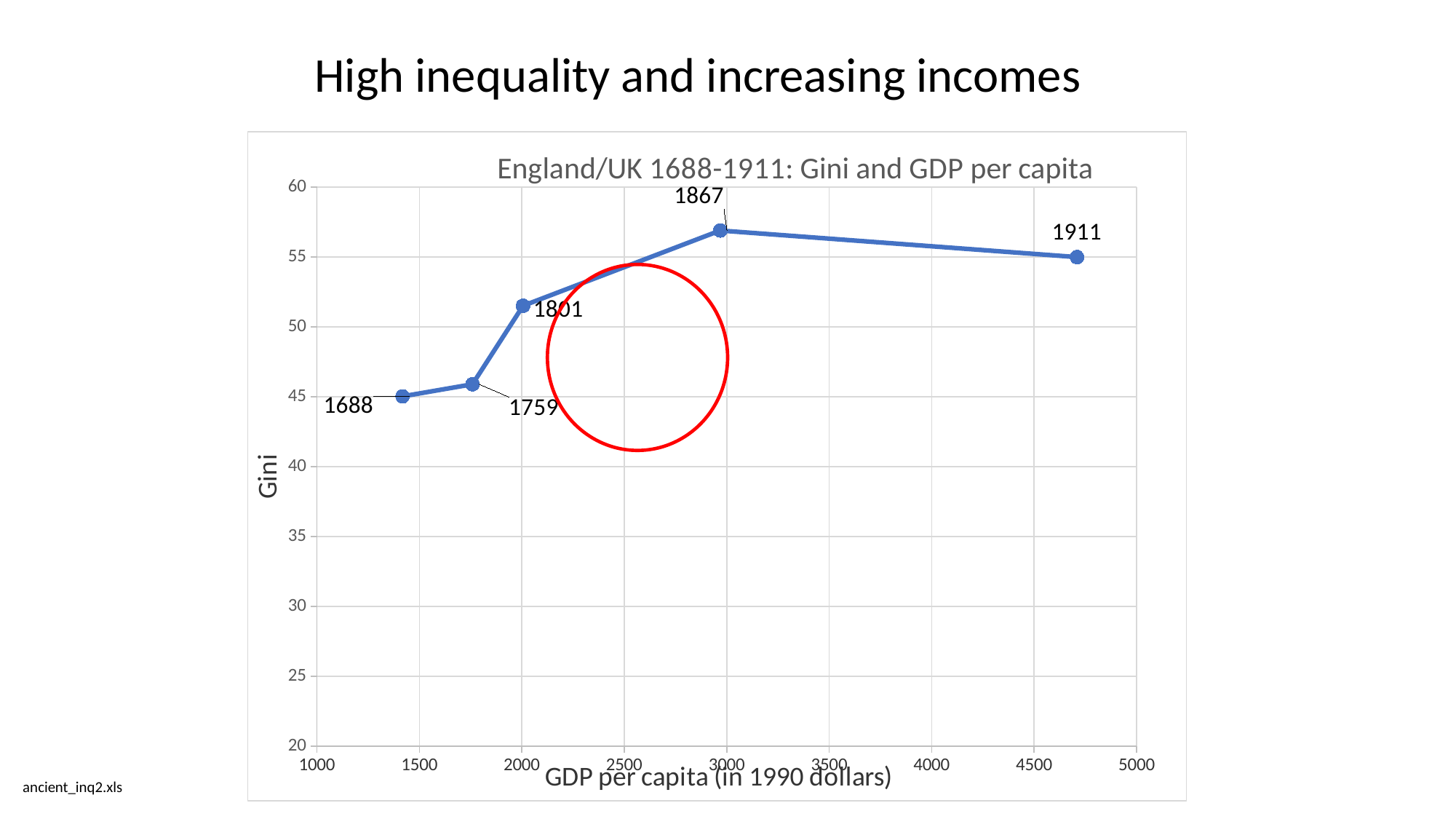
What is the label of the x axis? GDP per capita (in 1990 dollars) Is the Gini value for 1759 greater or less than 50? less What is the Gini value for 1688? 45 How many data points are plotted on the chart? 5 Is the GDP per capita for 1911 greater or less than 4500? greater Is the Gini value for 1801 greater or less than 50? greater Which year has the lowest Gini value? 1688 Which year has the highest Gini value? 1867 Which has the higher Gini value, 1867 or 1911? 1867 What kind of chart is shown on the slide? Line chart What is the Gini value for 1911? 55 What is the title of the chart? England/UK 1688-1911: Gini and GDP per capita